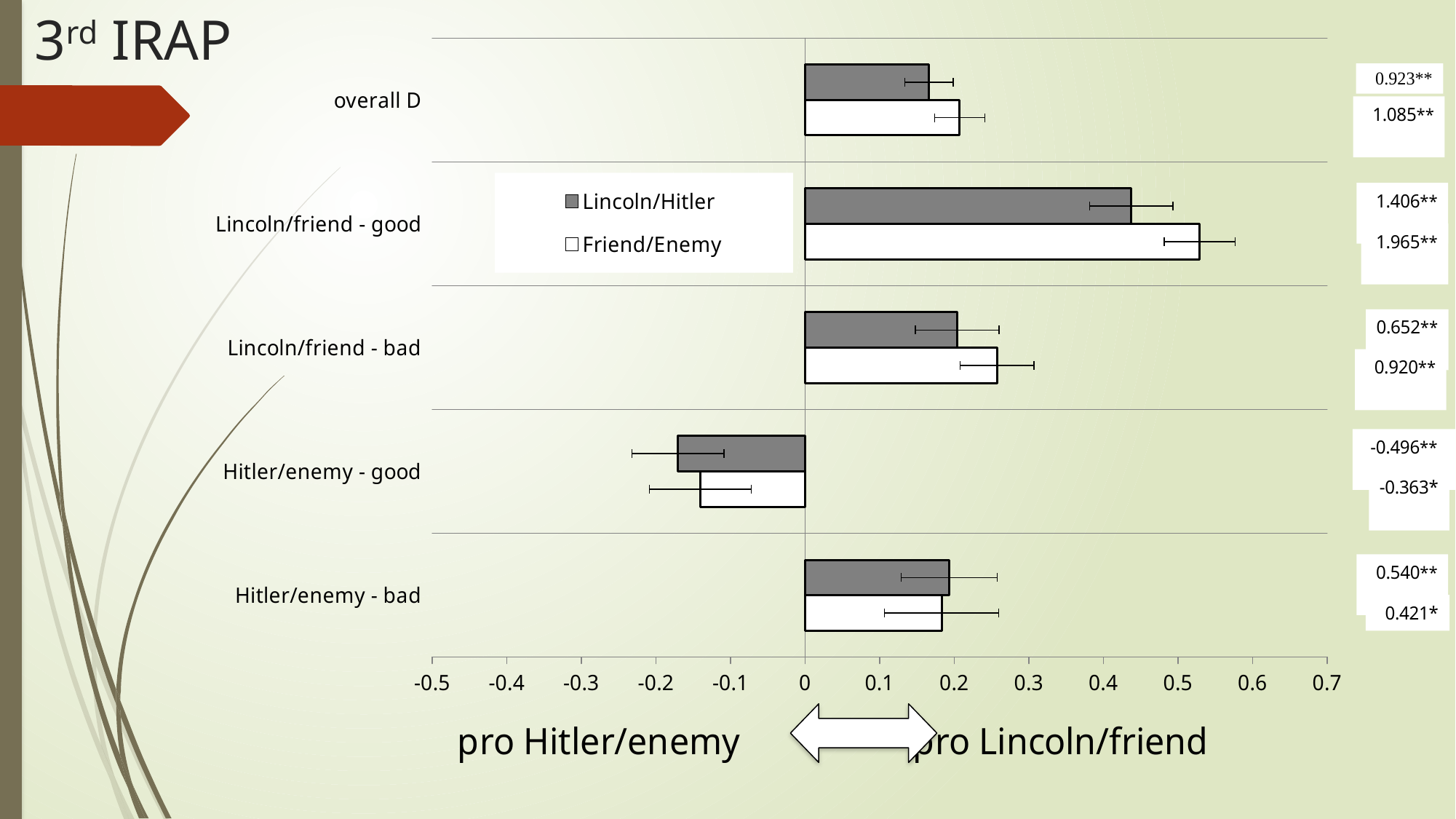
Is the Lincoln/Hitler value for Lincoln/friend - good greater or less than 0.5? less Is the Friend/Enemy value for Lincoln/friend - bad greater or less than 0.2? greater Which category has the lowest Lincoln/Hitler value? Hitler/enemy - good Which category has the highest Lincoln/Hitler value? Lincoln/friend - good For Lincoln/friend - good, which series has the larger value, Lincoln/Hitler or Friend/Enemy? Friend/Enemy Is the Friend/Enemy value for Lincoln/friend - good greater or less than 0.5? greater How many categories have negative values for both series? 1 Which category has the highest Friend/Enemy value? Lincoln/friend - good How many categories are plotted on the y axis of the chart? 5 What kind of chart is shown on the slide? bar chart How many series does the chart's legend list? 2